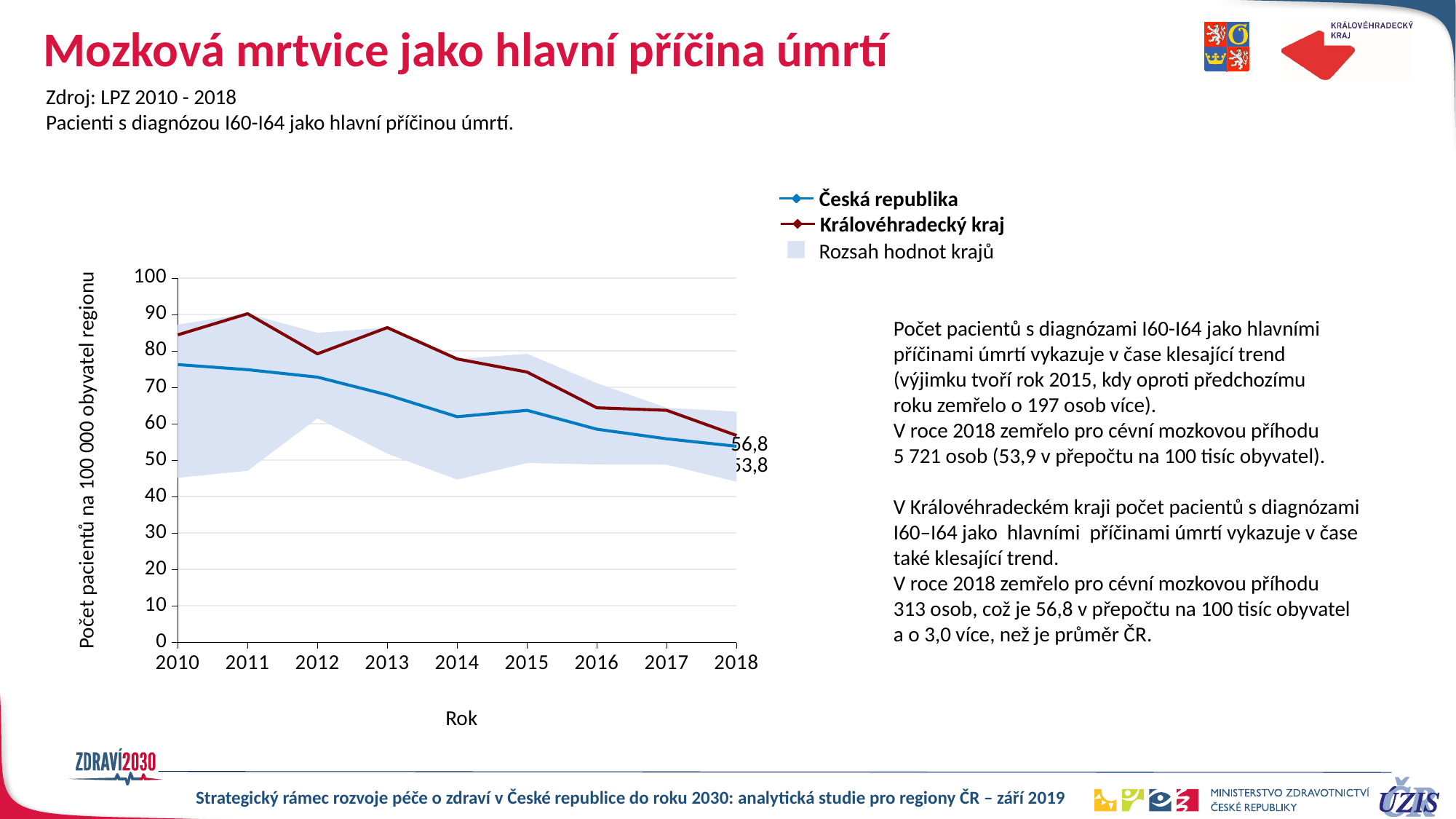
Is the value for Česká republika in 2014 greater or less than 70? less Is the value for Královéhradecký kraj in 2011 greater or less than 80? greater In which year does the Česká republika line reach its lowest value? 2018 What kind of chart is shown on the slide? line chart Do the values for Česká republika generally rise or fall from 2010 to 2018? fall What is the value for Královéhradecký kraj in 2018? 56,8 What is the title of the x axis of the chart? Rok Is the value for Česká republika in 2010 greater or less than 70? greater How many entries does the chart legend list? 3 In which year does the Královéhradecký kraj line reach its highest value? 2011 How many years are plotted along the x axis? 9 In 2018, which series has the higher value, Česká republika or Královéhradecký kraj? Královéhradecký kraj